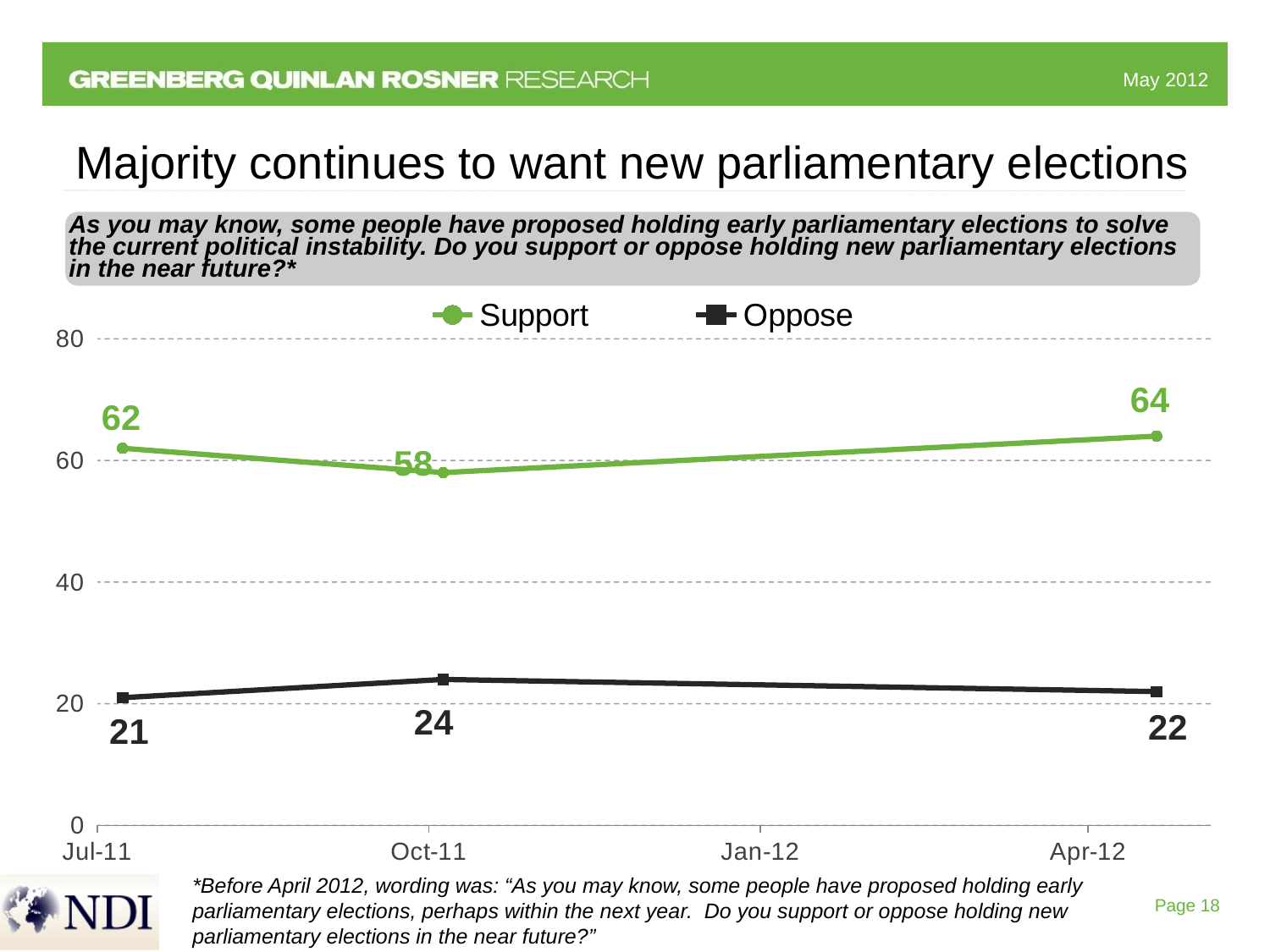
How many series does the legend list? 2 What is the Support value at the Oct-11 point? 58 Which series is higher at the Oct-11 point, Support or Oppose? Support At which point is the Support series lowest? Oct-11 What is the difference between Support and Oppose at the most recent (rightmost) point? 42 How many data points are plotted for the Support series? 3 What is the Support value at the most recent (rightmost) point? 64 What is the Oppose value at the Oct-11 point? 24 What is the Oppose value at the first point (Jul-11)? 21 What type of chart is shown on the slide? line chart What is the Support value at the first point (Jul-11)? 62 What is the Oppose value at the most recent (rightmost) point? 22